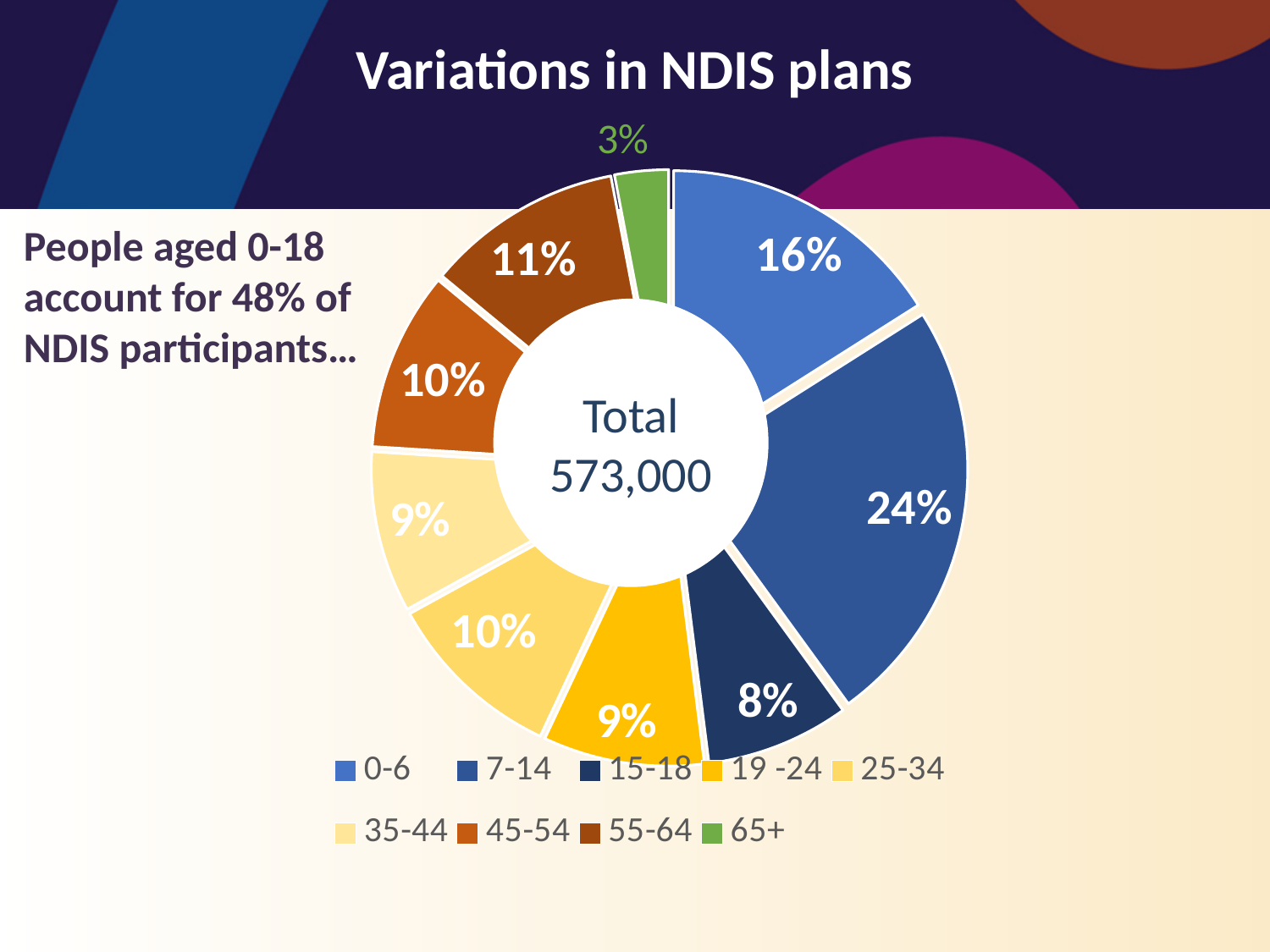
What percentage of NDIS participants are aged 0-6? 16% How many age groups are shown in the chart? 9 Which age group has the largest share of NDIS participants? 7-14 What kind of chart is shown on the slide? Doughnut (pie) chart What percentage of NDIS participants are aged 55-64? 11% What is the title of the slide containing the chart? Variations in NDIS plans Which age group has the smallest share of NDIS participants? 65+ What is the difference in percentage points between the 7-14 and 15-18 age groups? 16 What percentage of NDIS participants are aged 7-14? 24% Which age group has a larger share, 0-6 or 55-64? 0-6 What total number of participants is shown in the centre of the chart? 573,000 What percentage of NDIS participants are aged 65+? 3%